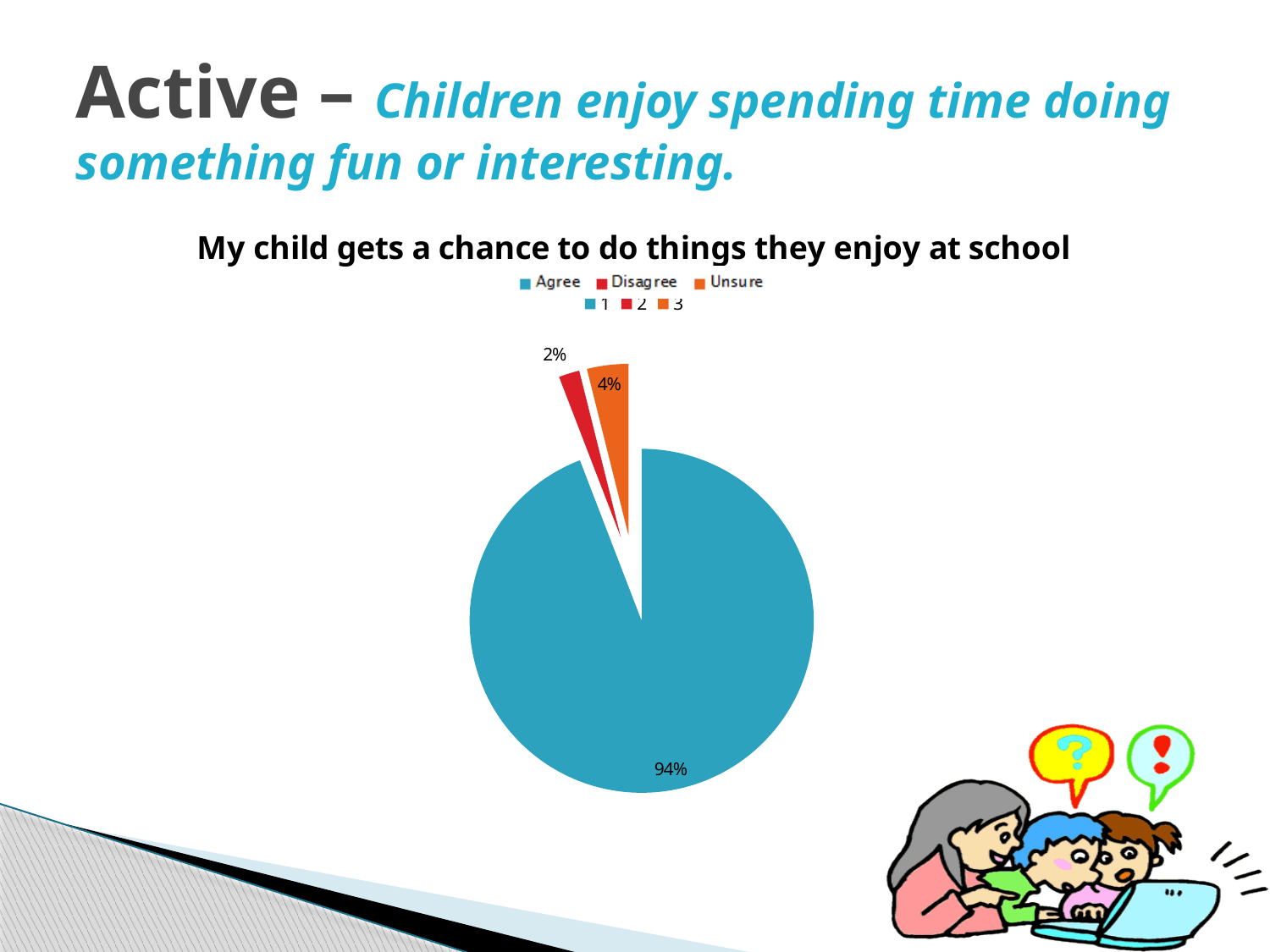
What colour is the Agree slice? Blue How many slices does the pie chart have? 3 Which is larger, the share for Unsure or the share for Disagree? Unsure What kind of chart is shown on the slide? Pie chart What percentage of respondents chose Unsure? 4% What percentage of respondents chose Disagree? 2% What is the difference in percentage points between Agree and Unsure? 90 Which response has the largest share of the pie? Agree What percentage of respondents chose Agree? 94% What is the title of the chart? My child gets a chance to do things they enjoy at school What is the difference in percentage points between Unsure and Disagree? 2 Which response has the smallest share of the pie? Disagree